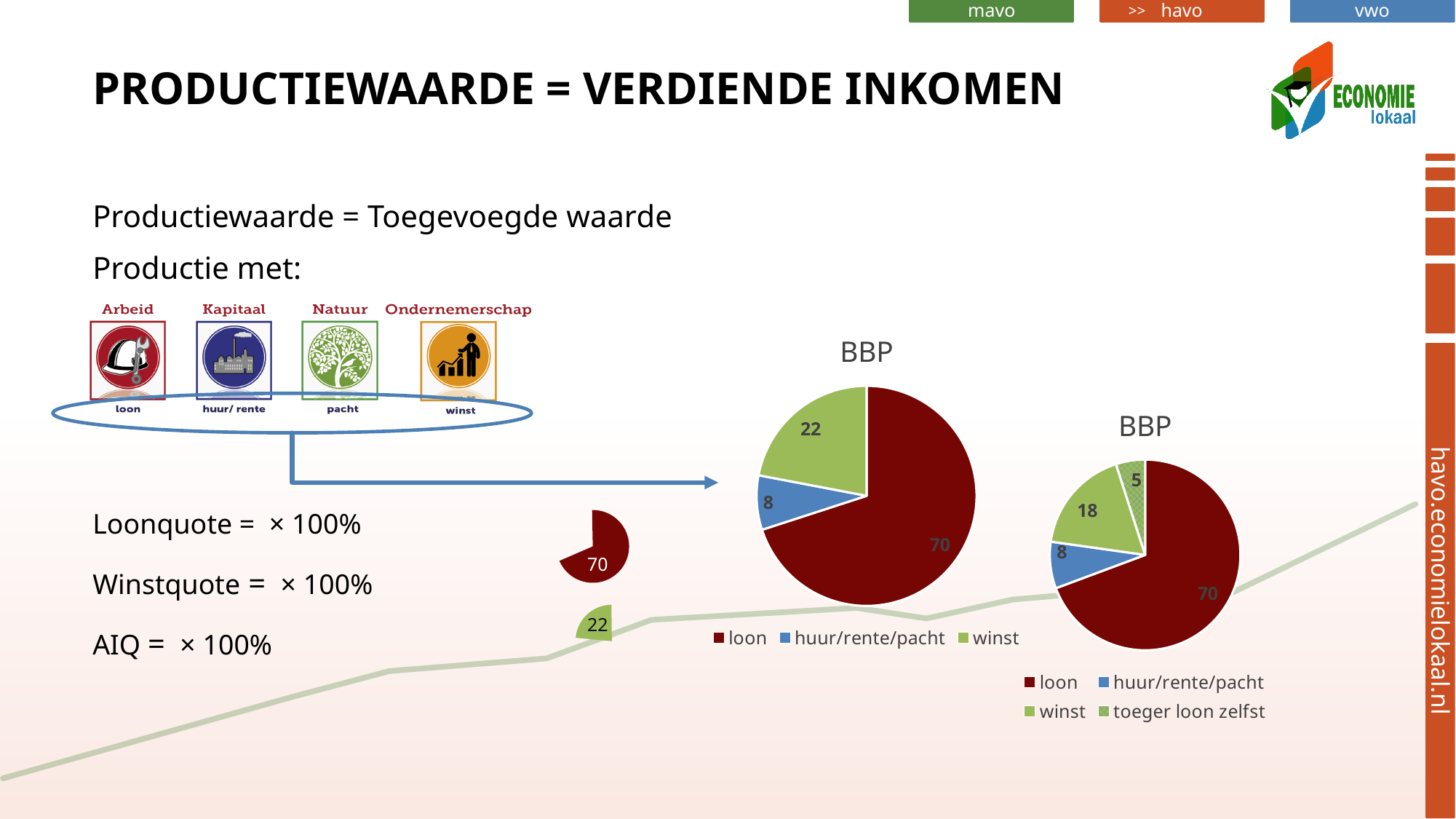
In the right BBP pie chart, what is the value for winst? 18 In the left BBP pie chart, what is the value for winst? 22 In the right BBP pie chart, which is larger: winst or huur/rente/pacht? winst In the left BBP pie chart, what is the difference between the values for winst and huur/rente/pacht? 14 In the left BBP pie chart, what share of the total does loon represent? 70% In the left BBP pie chart, what is the value for huur/rente/pacht? 8 In the left BBP pie chart, what is the value for loon? 70 In the left BBP pie chart, which category has the largest slice? loon In the right BBP pie chart, which category has the smallest slice? toeger loon zelfst What type of chart is the left BBP chart? pie chart How many categories does the legend of the right BBP pie chart list? 4 In the right BBP pie chart, what is the value for toeger loon zelfst? 5